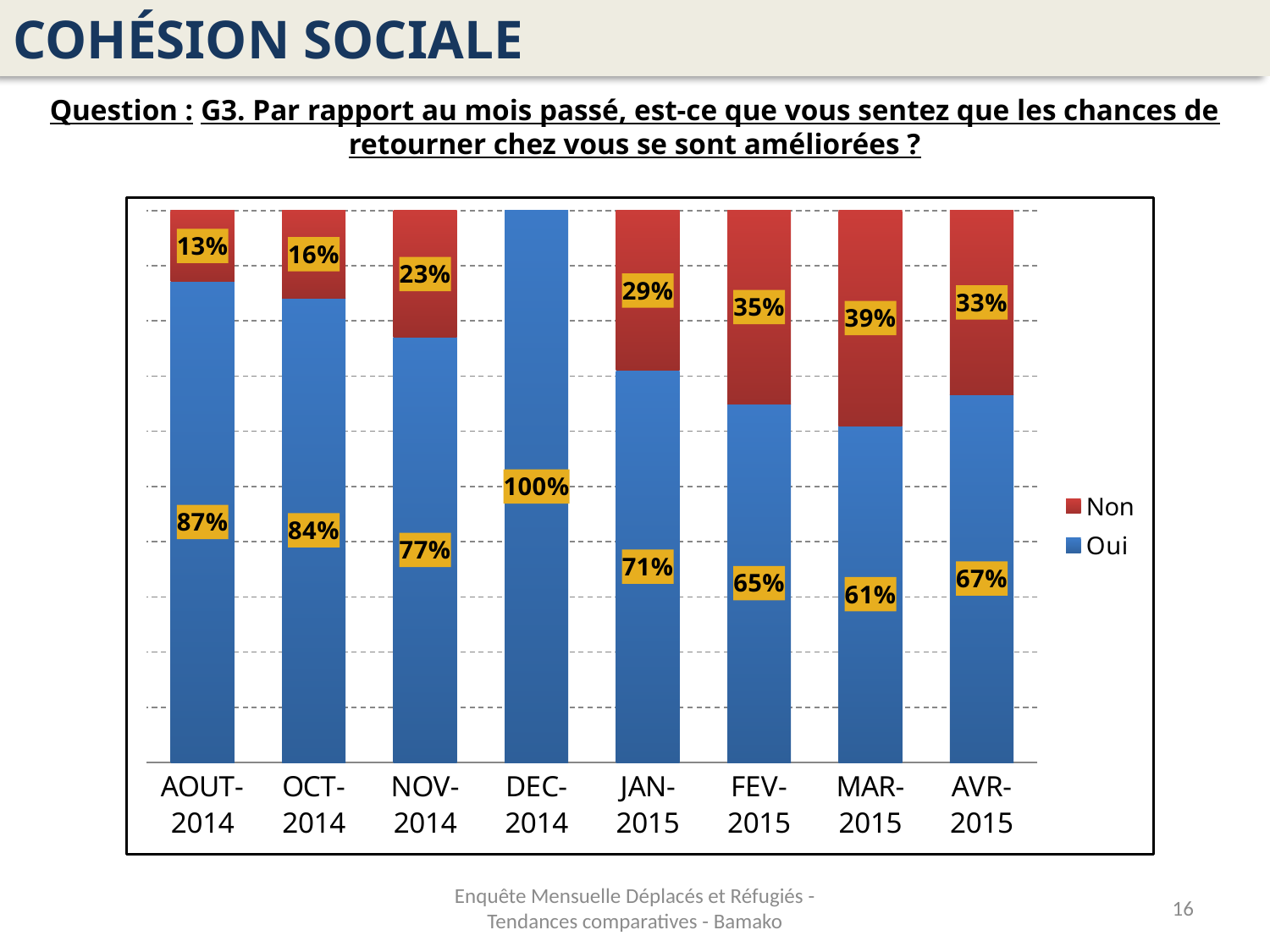
Which month has the lowest value for Oui? MAR-2015 Which month has the highest value for Non? MAR-2015 Which colour represents the Oui series in the chart? Blue What is the value for Non in NOV-2014? 23% How many months are shown on the x axis? 8 What kind of chart is shown on the slide? Stacked bar chart How many series does the legend list? 2 What is the value for Oui in DEC-2014? 100% What is the value for Oui in AOUT-2014? 87% What is the value for Non in MAR-2015? 39% What is the difference between the Oui values for AOUT-2014 and AVR-2015? 20% Which is larger, the Non value for FEV-2015 or the Non value for JAN-2015? FEV-2015